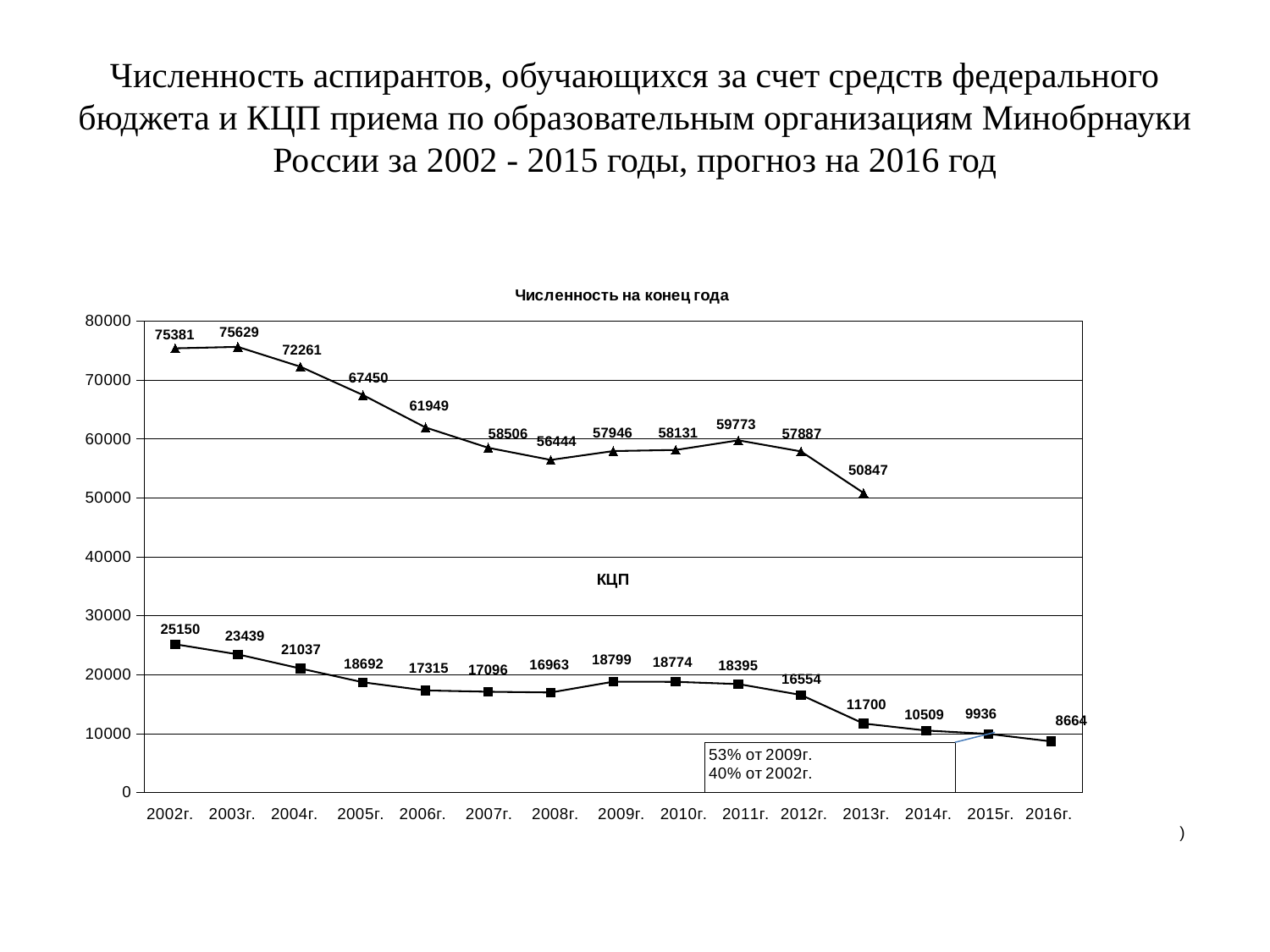
What is the value of the Численность на конец года series for 2002г.? 75381 Is the value of the Численность на конец года series for 2013г. greater or less than 60000? less What is the difference between the КЦП values for 2002г. and 2016г.? 16486 In which year does the КЦП series have its lowest value? 2016г. What is the value of the КЦП series for 2009г.? 18799 Which is larger for the Численность на конец года series: the value for 2011г. or the value for 2012г.? 2011г. What kind of chart is shown on the slide? line chart What is the difference between the Численность на конец года values for 2012г. and 2013г.? 7040 In which year does the Численность на конец года series reach its highest value? 2003г. Does the КЦП series generally rise or fall from 2002г. to 2016г.? fall How many years are shown on the x axis? 15 What is the value of the КЦП series for 2016г.? 8664